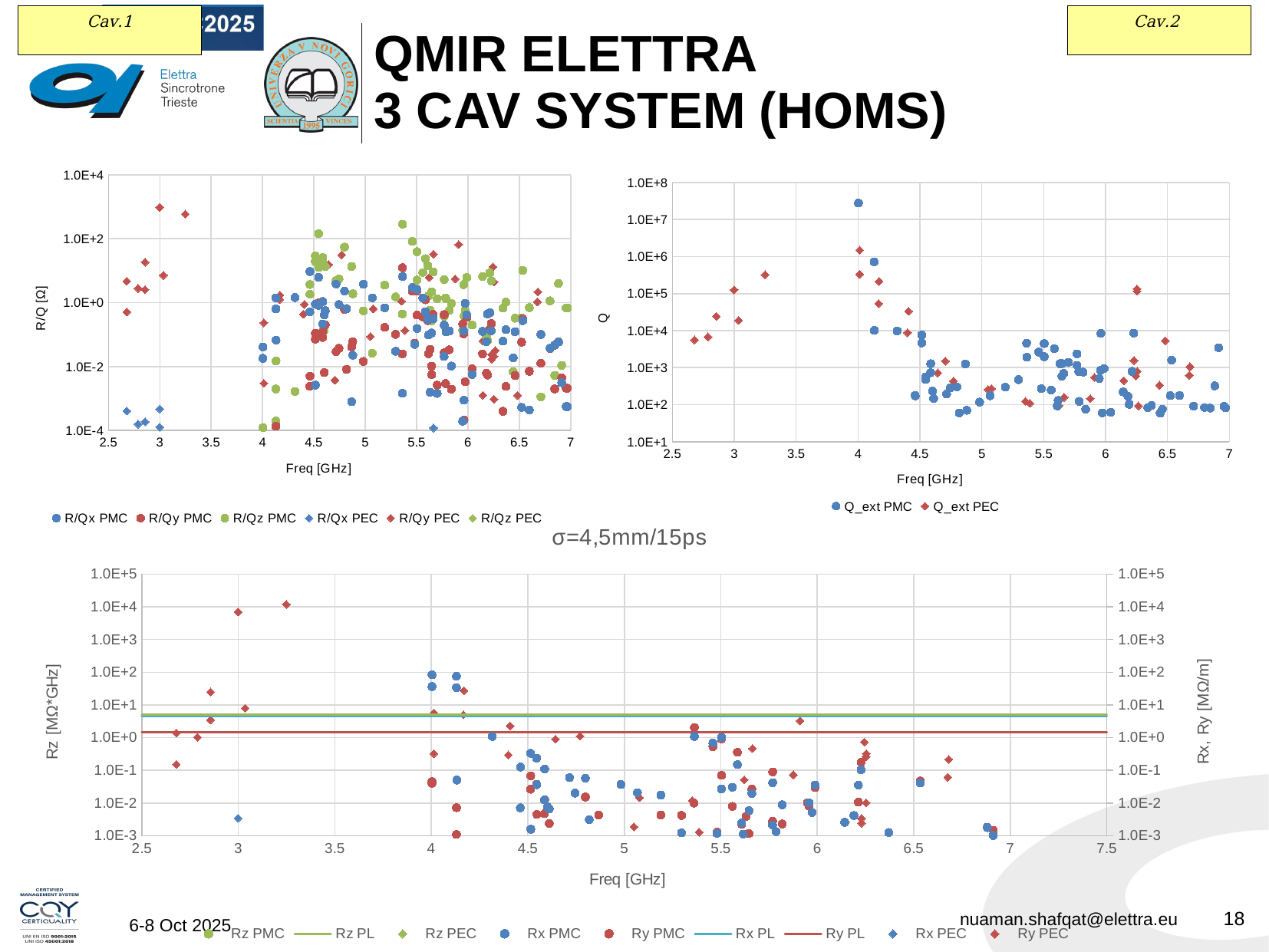
What is the y-axis label of the top-right chart? Q What is the x-axis label of the bottom chart? Freq [GHz] How many entries does the legend of the bottom Rz chart list? 9 How many series does the legend of the top-left R/Q chart list? 6 In the top-right Q chart, is the highest Q_ext PMC value (near 4 GHz) greater or less than 1.0E+7? greater In the top-right Q chart, is the Q_ext PEC point near 6.25 GHz at the top of the cluster greater or less than 1.0E+4? greater In the bottom chart, is the Rz PL line greater or less than 1.0E+1? less How many series does the legend of the top-right Q chart list? 2 What kind of chart is the top-left R/Q chart? scatter chart